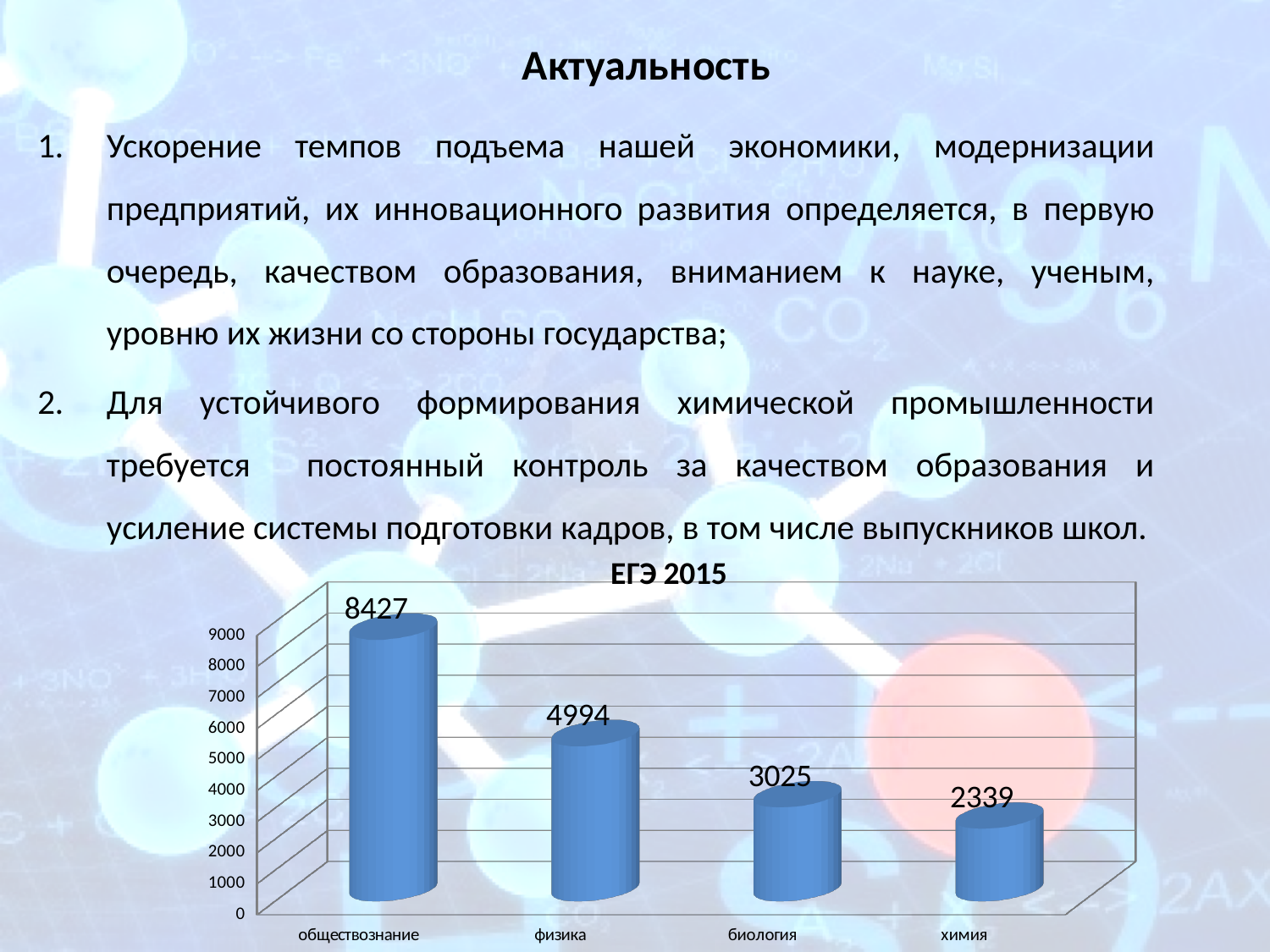
What is the difference between the values for обществознание and физика in the ЕГЭ 2015 chart? 3433 What kind of chart is the ЕГЭ 2015 chart? bar chart How many categories are shown in the ЕГЭ 2015 chart? 4 What is the value for биология in the ЕГЭ 2015 chart? 3025 Which category has the highest value in the ЕГЭ 2015 chart? обществознание Which is larger in the ЕГЭ 2015 chart, физика or биология? физика What is the value for физика in the ЕГЭ 2015 chart? 4994 Is the value for химия greater or less than 3000 in the ЕГЭ 2015 chart? less Which category has the lowest value in the ЕГЭ 2015 chart? химия What is the value for химия in the ЕГЭ 2015 chart? 2339 What is the difference between the values for биология and химия in the ЕГЭ 2015 chart? 686 What is the value for обществознание in the ЕГЭ 2015 chart? 8427